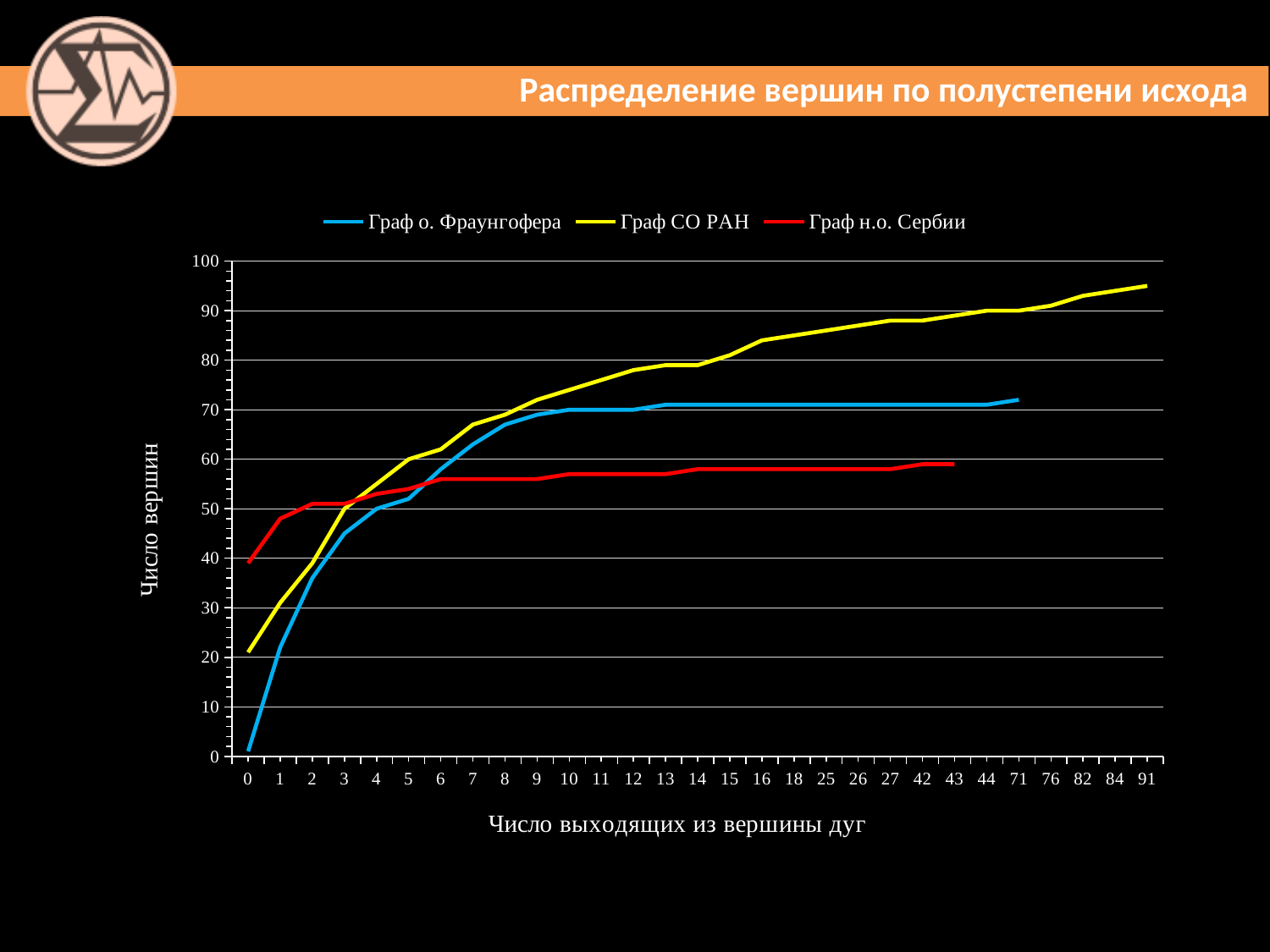
How many categories are shown on the x axis? 29 What kind of chart is shown on the slide? line chart Is the value for Граф о. Фраунгофера at x = 0 greater or less than 10? less Which series reaches the highest value on the chart? Граф СО РАН How many series does the legend list? 3 What is the title of the slide's chart? Распределение вершин по полустепени исхода Is the value for Граф СО РАН at x = 91 greater or less than 90? greater At x = 16, which is larger: the value for Граф СО РАН or the value for Граф н.о. Сербии? Граф СО РАН What is the label of the y axis? Число вершин Do the values for Граф СО РАН rise or fall along the x axis? rise Is the value for Граф н.о. Сербии at x = 0 greater or less than 50? less Which series has the lowest value at x = 0? Граф о. Фраунгофера